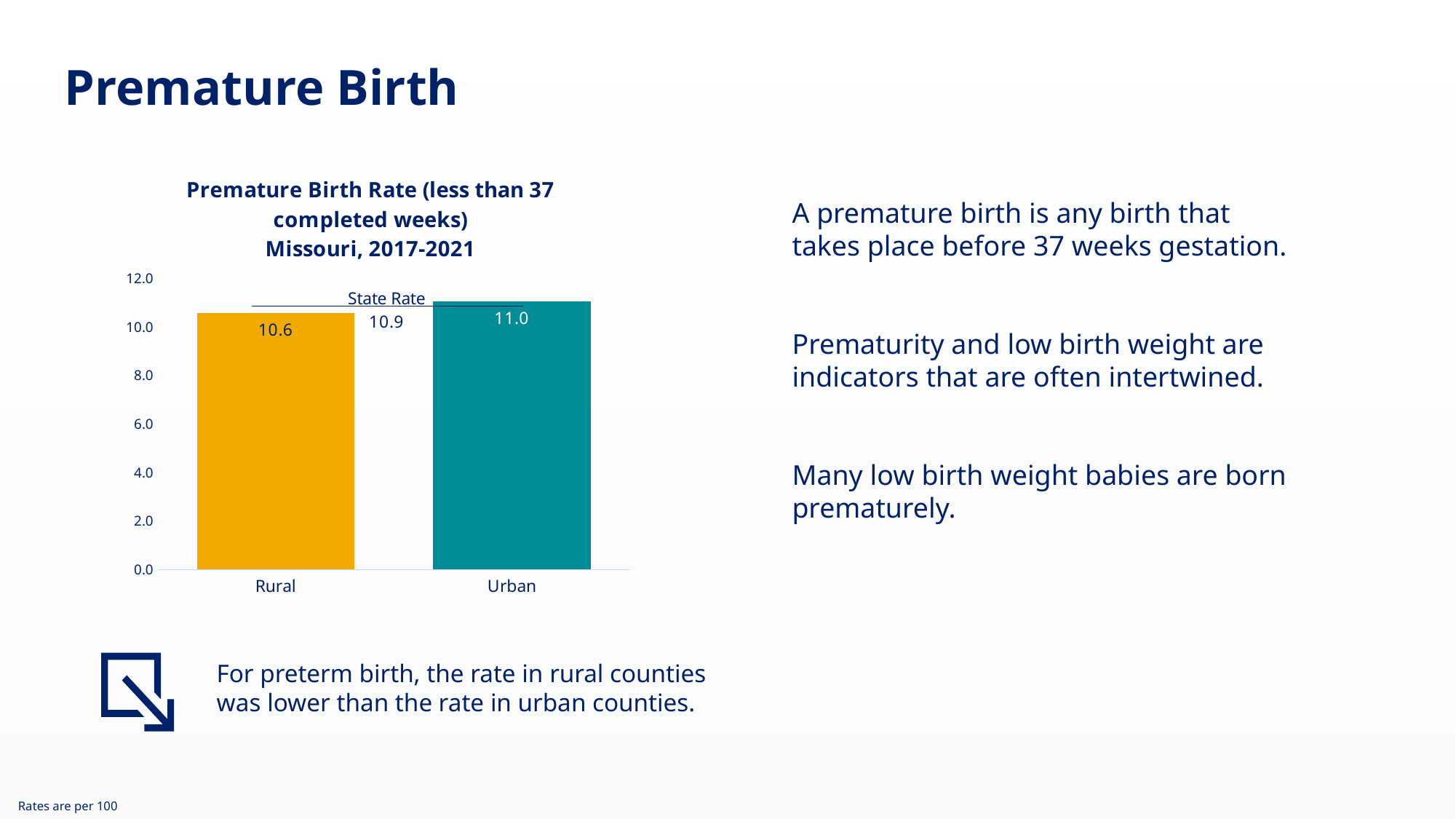
Is the value for Rural greater or less than 10.0? greater Is the value for Urban greater or less than 12.0? less What is the difference between the Urban and Rural premature birth rates? 0.4 What is the premature birth rate for Urban counties? 11.0 How many categories are plotted on the chart? 2 Which category has the higher premature birth rate, Rural or Urban? Urban What is the State Rate shown on the chart? 10.9 What is the title of the chart? Premature Birth Rate (less than 37 completed weeks) Missouri, 2017-2021 What is the premature birth rate for Rural counties? 10.6 Which category has the lowest premature birth rate? Rural What colour is the Urban bar? Teal What kind of chart is shown on the slide? Bar chart